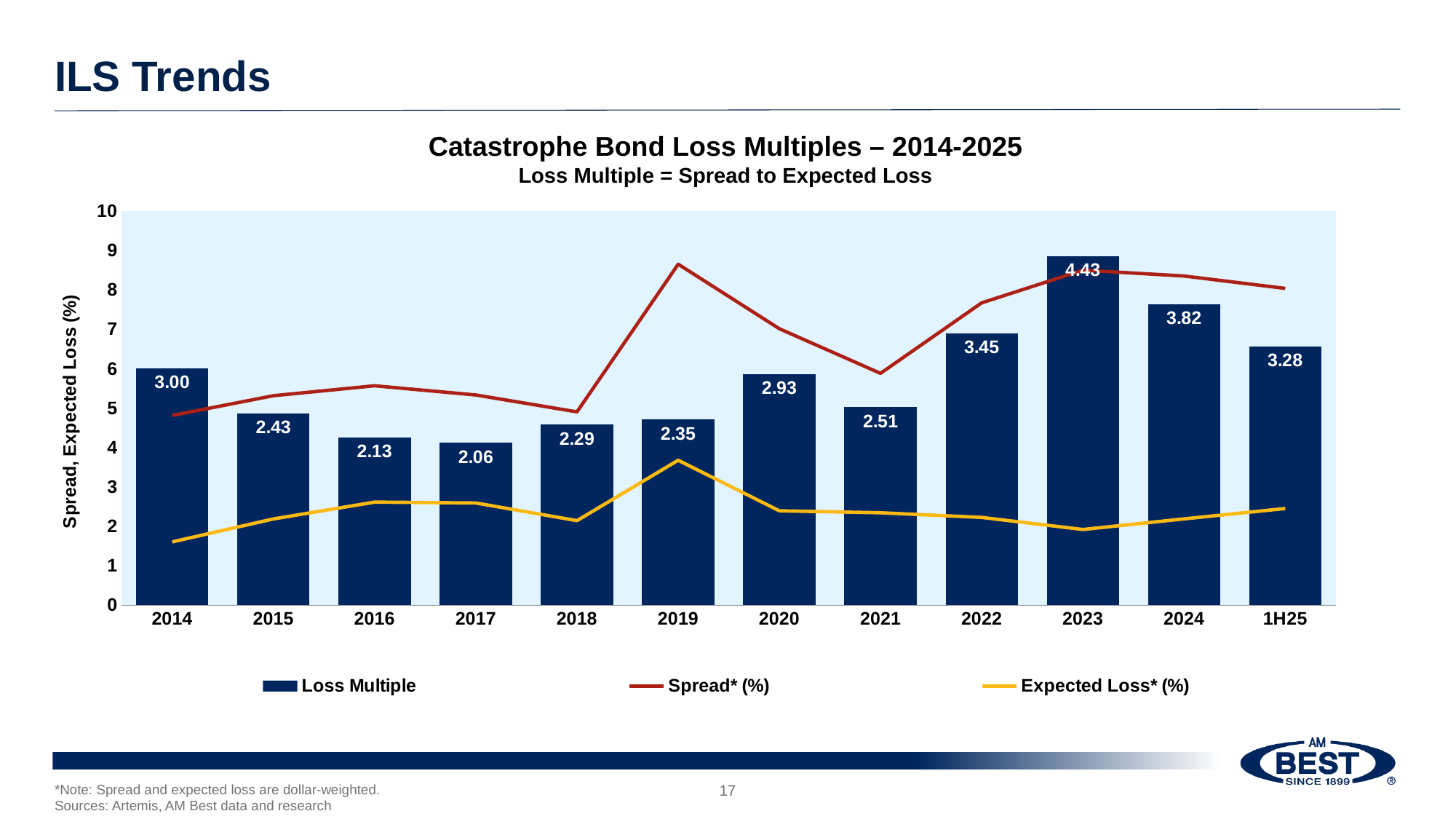
Is the Expected Loss* (%) value for 2014 greater or less than 2? less What is the Loss Multiple for 2017? 2.06 Is the Spread* (%) value for 2019 greater or less than 8? greater How many series does the legend list? 3 Which year has the lowest Loss Multiple? 2017 Which year has the highest Loss Multiple? 2023 What is the label of the vertical axis? Spread, Expected Loss (%) What is the difference between the Loss Multiple in 2023 and in 2024? 0.61 How many periods are shown on the x axis? 12 What is the Loss Multiple for 1H25? 3.28 What is the Loss Multiple for 2023? 4.43 Which is larger, the Loss Multiple for 2020 or for 2021? 2020